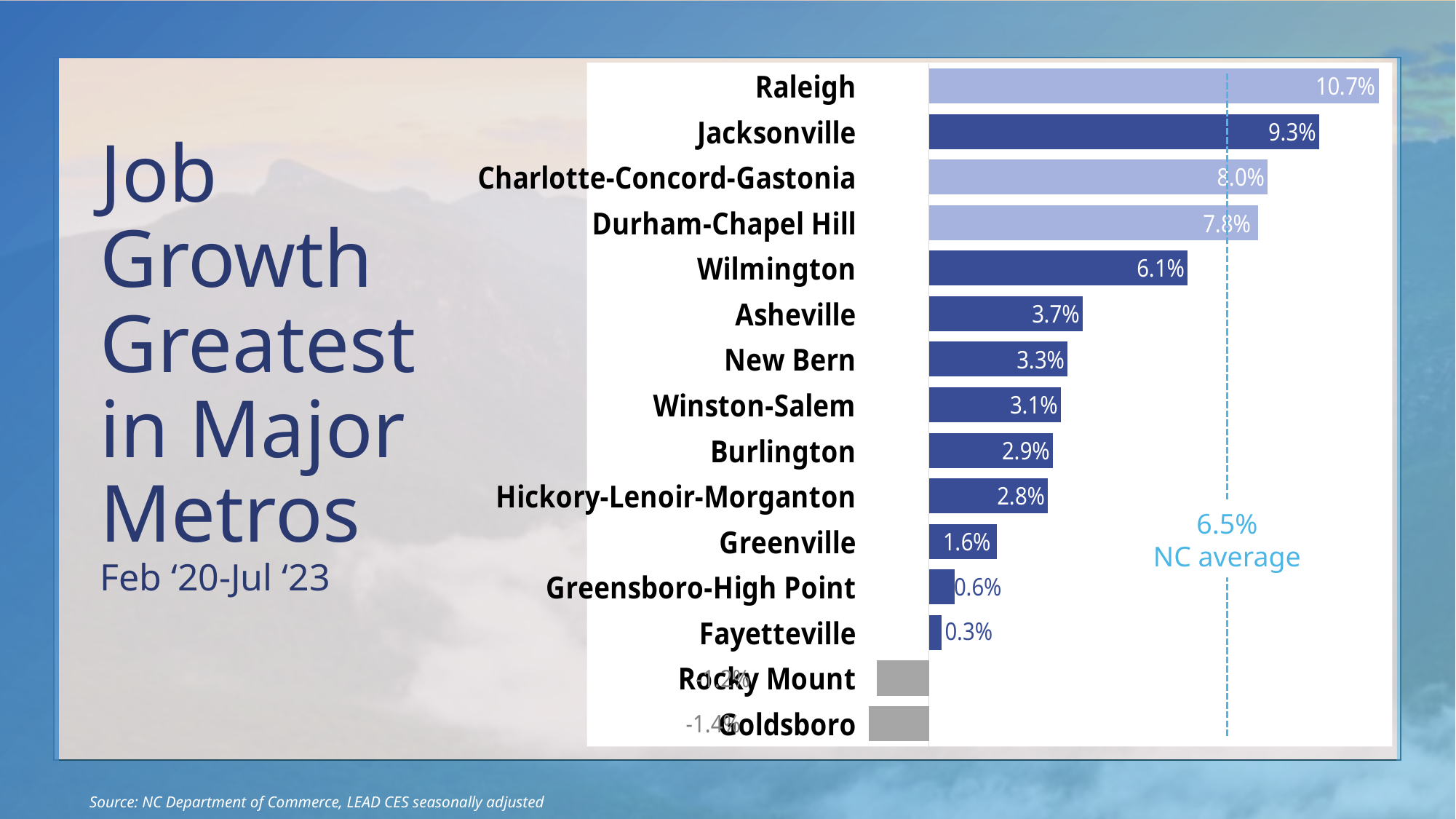
How many metros are shown in the chart? 15 Which has higher job growth, New Bern or Burlington? New Bern What kind of chart is shown on the slide? Bar chart What is the job growth value for Wilmington? 6.1% What is the job growth value for Hickory-Lenoir-Morganton? 2.8% What is the job growth value for Fayetteville? 0.3% What is the difference in job growth between Jacksonville and Charlotte-Concord-Gastonia? 1.3% What is the difference in job growth between Asheville and Greenville? 2.1% Which has higher job growth, Durham-Chapel Hill or Wilmington? Durham-Chapel Hill Which metro has the highest job growth? Raleigh What is the NC average job growth marked by the dashed line? 6.5% What is the job growth value for Raleigh? 10.7%